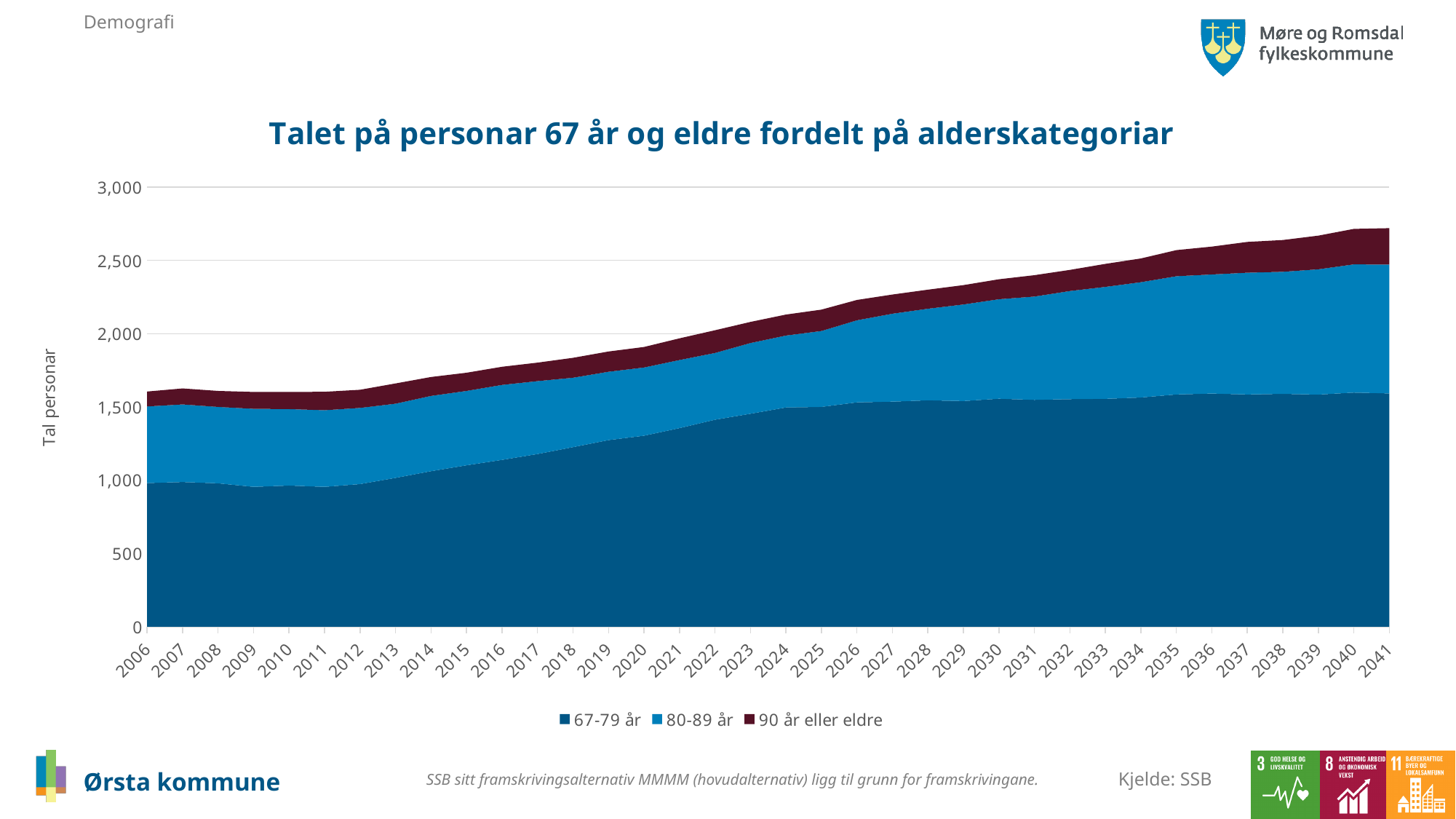
Is the total value for 2006 greater or less than 1,500? greater In 2041, which series is larger: 67-79 år or 80-89 år? 67-79 år Does the total number of persons 67 years and older rise or fall from 2006 to 2041? Rise Is the total value for 2041 greater or less than 2,500? greater Is the value for 67-79 år in 2041 greater or less than 1,500? greater What kind of chart is shown on the slide? Stacked area chart Which age category contributes the most persons across the whole period? 67-79 år How many years are shown along the x axis? 36 What is the title of the chart? Talet på personar 67 år og eldre fordelt på alderskategoriar How many series does the legend list? 3 What is the label on the y axis? Tal personar